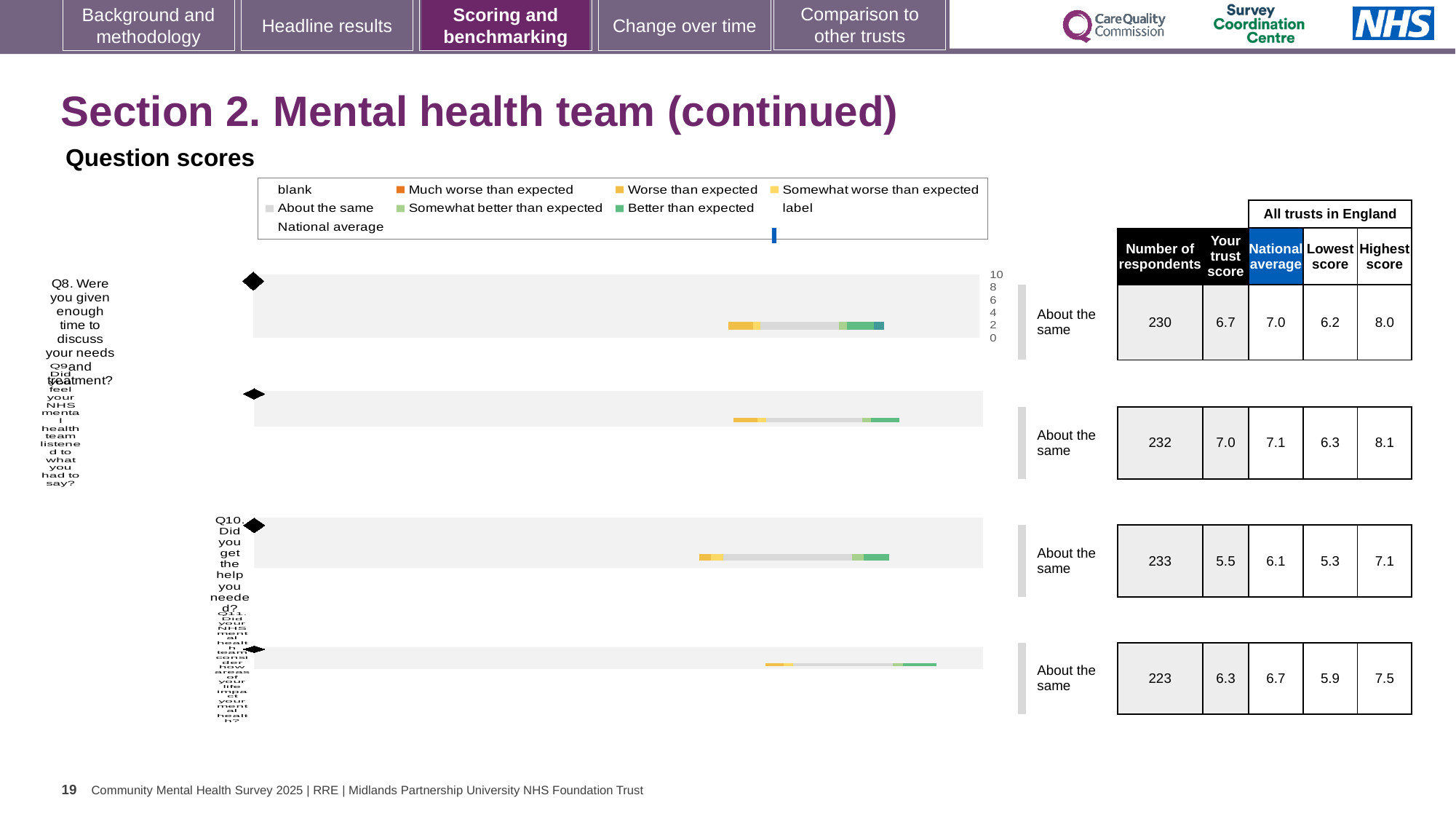
What is the national average score for Q9 (Did you feel your NHS mental health team listened to what you had to say?)? 7.1 What is the highest score across all trusts in England for Q11? 7.5 Which has the larger trust score, Q9 or Q11? Q9 What benchmark category is shown next to the Q8 chart? About the same What kind of chart is used to show the question scores? Bar chart How many respondents answered Q10 (Did you get the help you needed?)? 233 Which question has the lowest 'Your trust score' on this slide? Q10 What is the difference between the national average and the trust score for Q8? 0.3 What is the 'Your trust score' value for Q8 (Were you given enough time to discuss your needs and treatment?)? 6.7 Which question has the highest number of respondents? Q10 What is the lowest score across all trusts in England for Q10? 5.3 How many questions are charted on this slide? 4